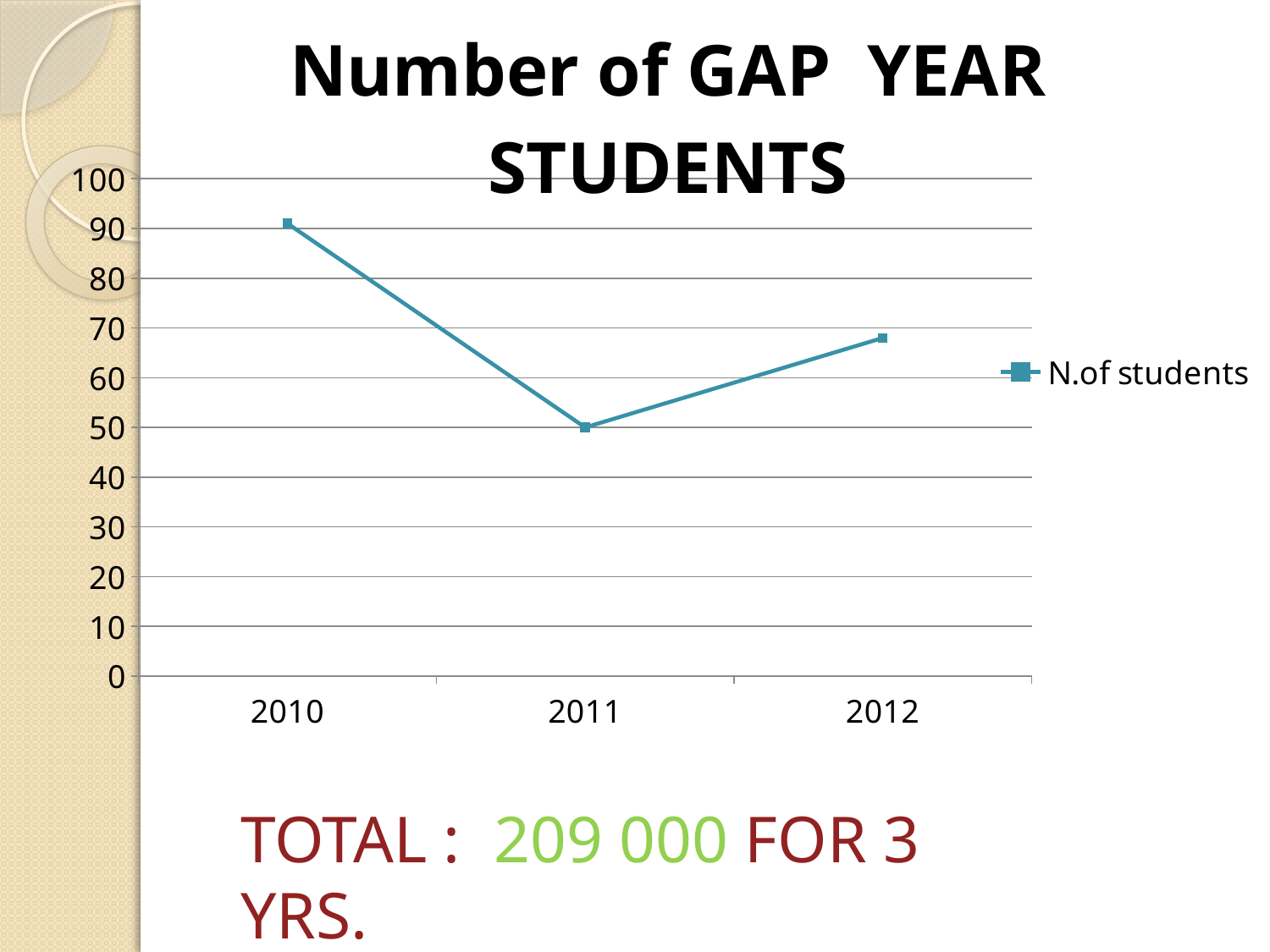
How many years are plotted on the x axis? 3 What series name does the legend show? N.of students Is the value for 2012 greater or less than 60? greater Is the value for 2010 greater or less than 80? greater What is the title of the chart? Number of GAP YEAR STUDENTS Which is larger, the value for 2010 or the value for 2012? 2010 Which year has the lowest number of students? 2011 What kind of chart is shown on the slide? line chart Does the number of students rise or fall from 2010 to 2011? fall How many series does the legend list? 1 Which year has the highest number of students? 2010 What is the value for 2011? 50